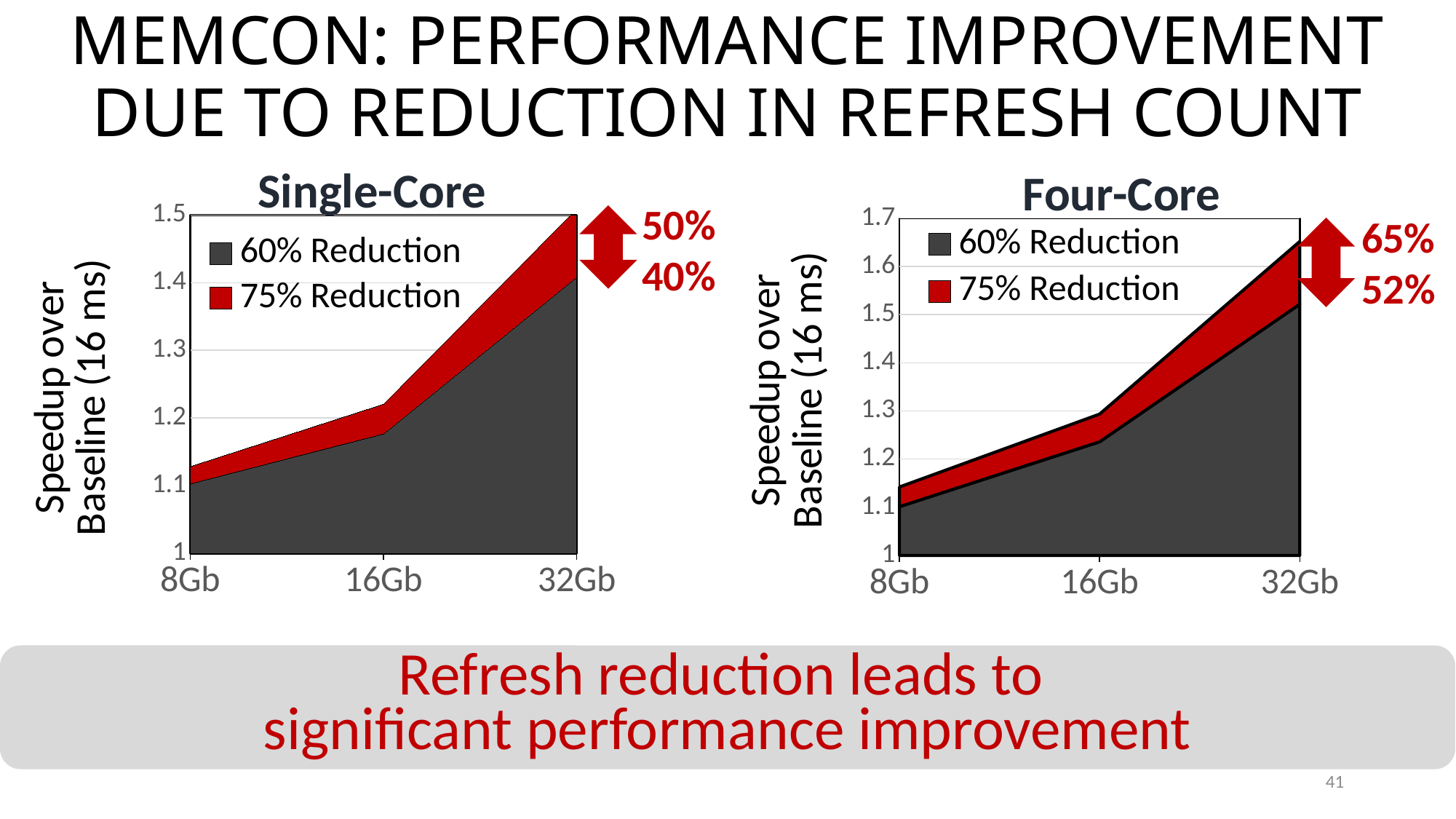
In the Four-Core chart, at which memory size is the 60% Reduction speedup lowest? 8Gb In the Single-Core chart, do the speedup values rise or fall from 8Gb to 32Gb? rise What is the y-axis label of the Four-Core chart? Speedup over Baseline (16 ms) How many series does the legend of the Four-Core chart list? 2 What kind of chart is the Single-Core chart? area chart In the Single-Core chart, is the 75% Reduction value at 16Gb greater or less than 1.3? less In the Single-Core chart, is the 60% Reduction value at 32Gb greater or less than 1.3? greater In the Single-Core chart, at which memory size is the 75% Reduction speedup highest? 32Gb In the Four-Core chart, which series is higher at 32Gb, 60% Reduction or 75% Reduction? 75% Reduction In the Four-Core chart, is the 60% Reduction value at 8Gb greater or less than 1.2? less How many x-axis categories does the Single-Core chart have? 3